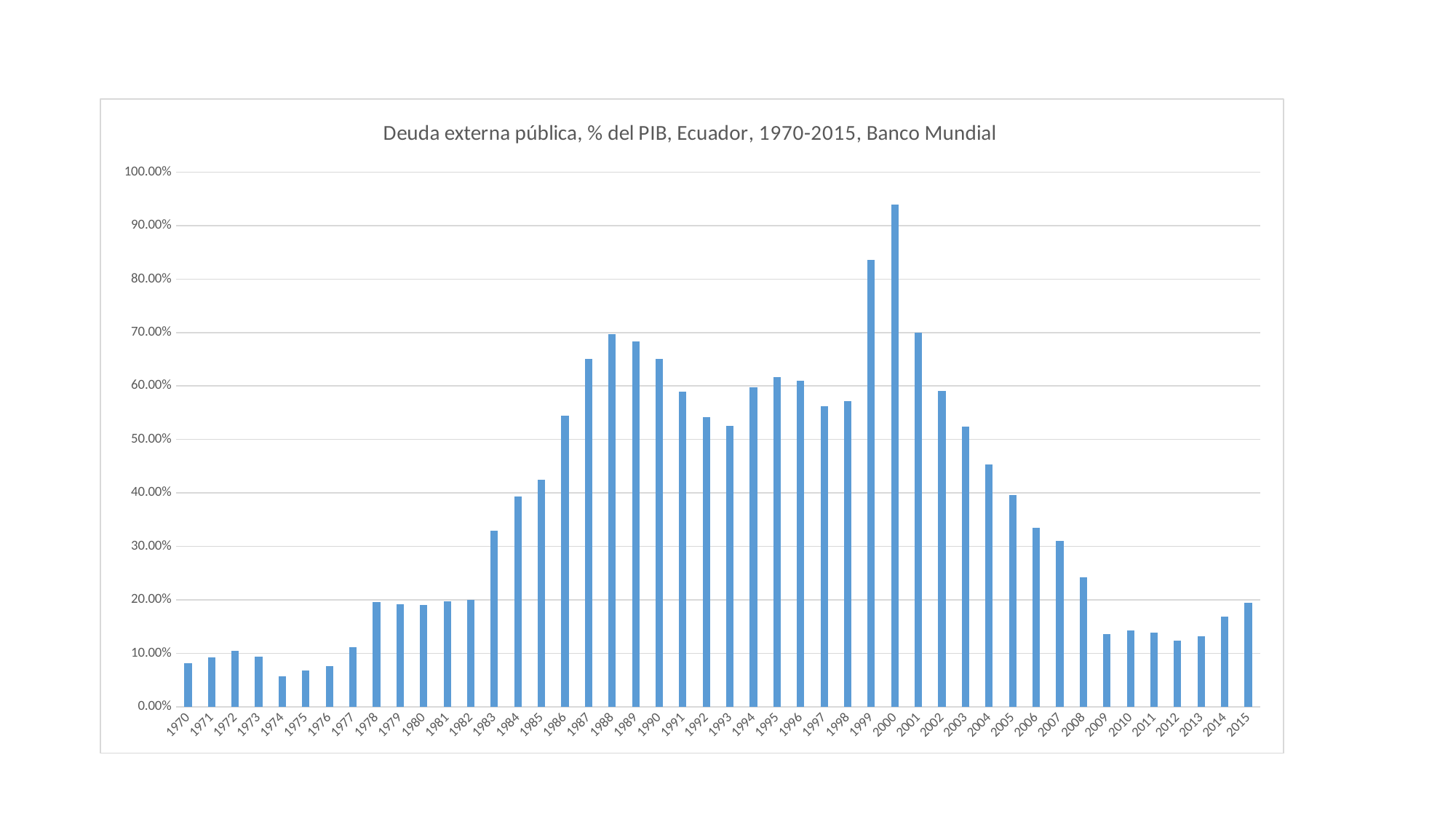
Which year has the larger value, 1999 or 2001? 1999 Which year has the larger value, 2005 or 2006? 2005 Is the value for 1999 greater or less than 80.00%? greater What is the title of the chart? Deuda externa pública, % del PIB, Ecuador, 1970-2015, Banco Mundial What kind of chart is shown on the slide? Bar chart How many years (bars) are plotted in the chart? 46 Is the value for 1974 greater or less than 10.00%? less Which year has the highest value in the chart? 2000 Do the values rise or fall from 2001 to 2009? Fall Is the value for 2008 greater or less than 20.00%? greater Which year has the lowest value in the chart? 1974